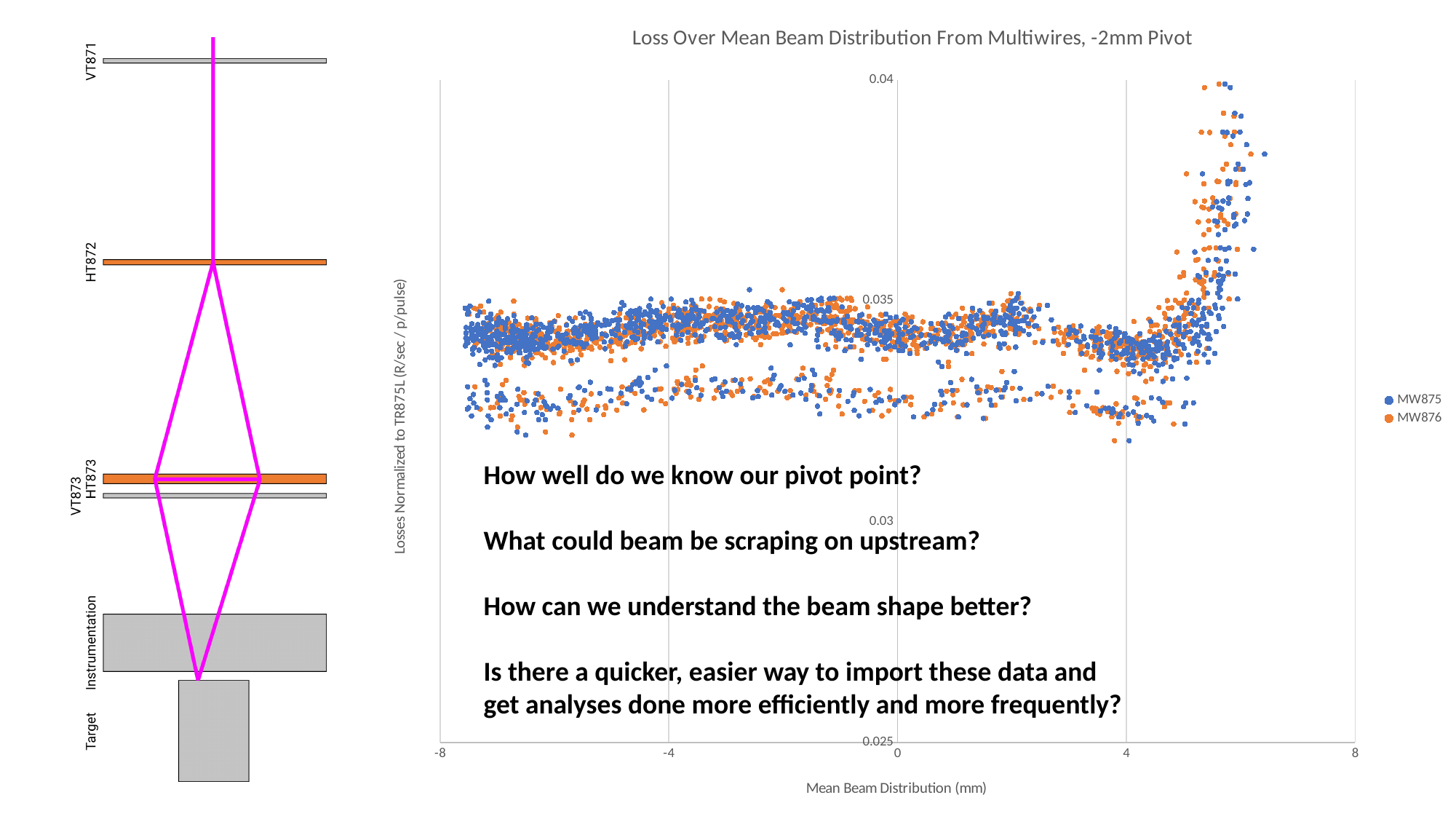
Are the highest loss values in the chart found at the left end or the right end of the x axis? right end What is the label of the x axis of the chart? Mean Beam Distribution (mm) What kind of chart is shown on the slide? scatter chart What is the highest value shown on the x axis of the chart? 8 Do the loss values rise or fall as the mean beam distribution increases beyond 4 mm? rise Which series is plotted in orange in the chart? MW876 Are the loss values for the lower band of points near a mean beam distribution of -4 mm greater or less than 0.035? less Are the loss values for the main band of points near a mean beam distribution of -4 mm greater or less than 0.04? less How many series does the legend of the chart list? 2 What is the title of the chart? Loss Over Mean Beam Distribution From Multiwires, -2mm Pivot Are the loss values for the main band of points near a mean beam distribution of 0 mm greater or less than 0.03? greater What is the lowest value shown on the y axis of the chart? 0.025